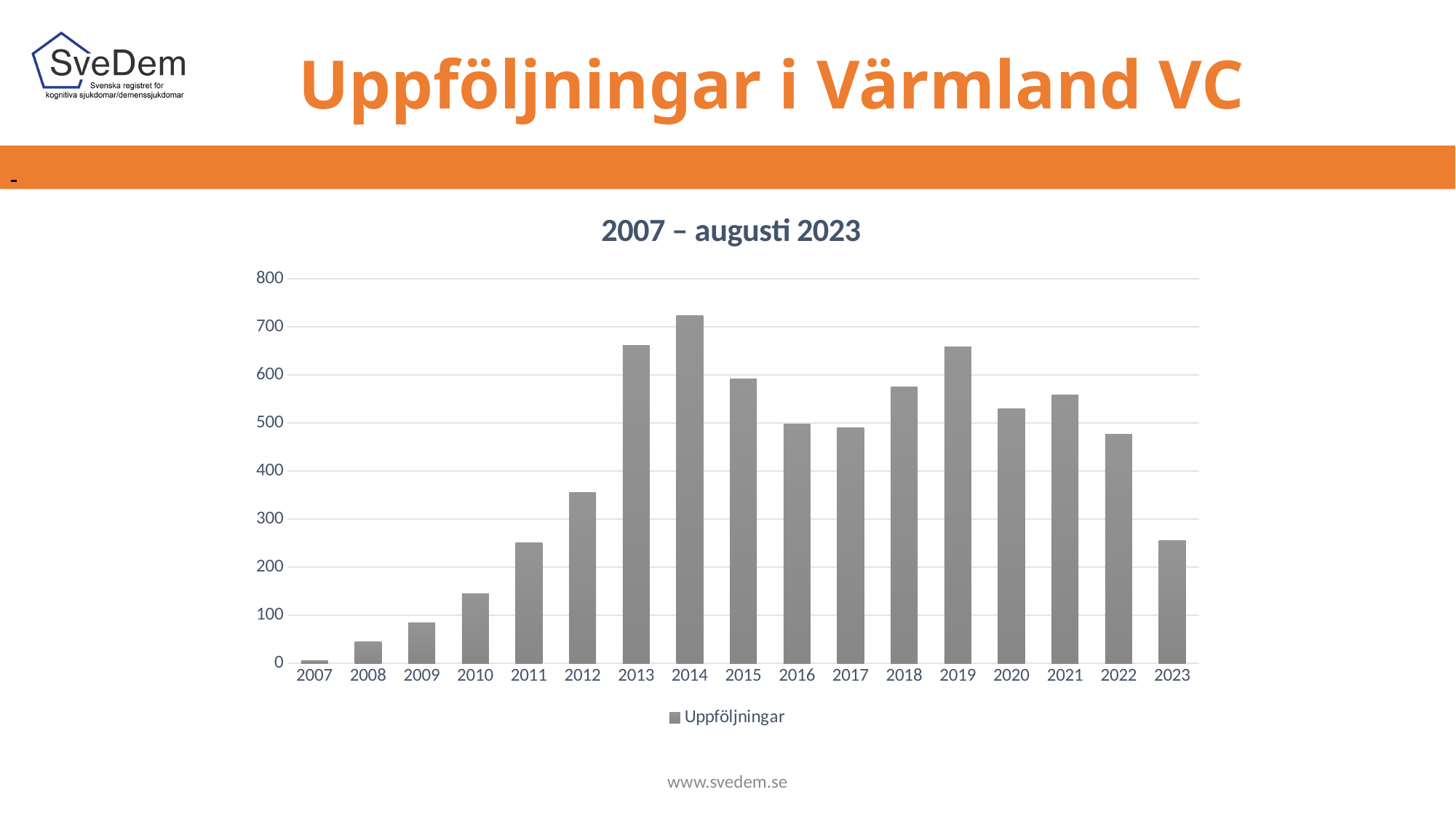
Which year has the lowest number of Uppföljningar? 2007 Is the value for 2023 greater or less than 300? less Is the value for 2014 greater or less than 700? greater How many years are shown on the x axis of the chart? 17 Is the value for 2012 greater or less than 300? greater Which year has the highest number of Uppföljningar? 2014 How many series does the legend list? 1 What kind of chart is shown on the slide? bar chart Which year has a higher value, 2012 or 2013? 2013 Which year has a higher value, 2014 or 2019? 2014 Do the values rise or fall from 2007 to 2014? rise